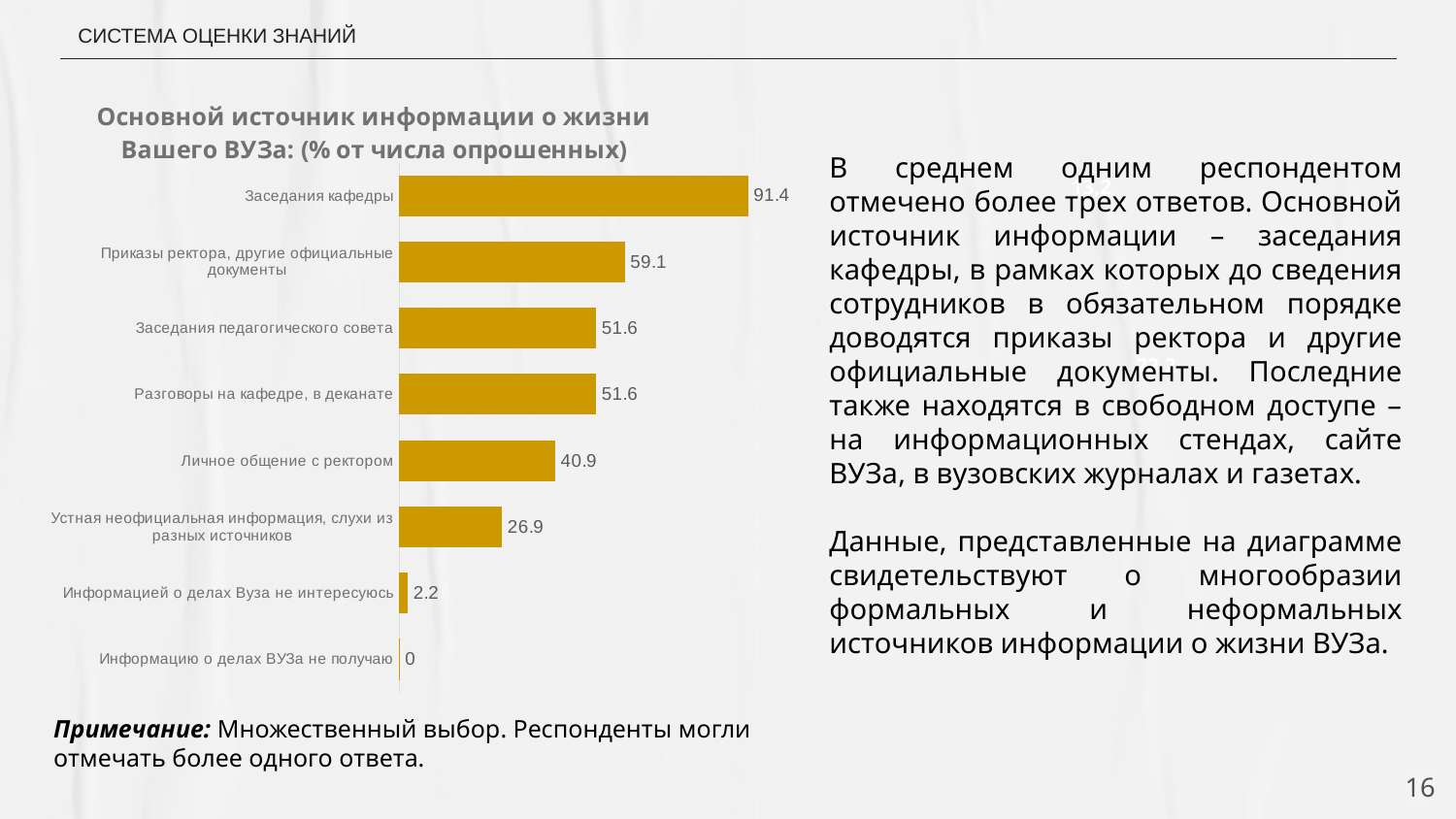
Which is larger: the value for "Личное общение с ректором" or for "Устная неофициальная информация, слухи из разных источников"? Личное общение с ректором What is the title of the chart? Основной источник информации о жизни Вашего ВУЗа: (% от числа опрошенных) Which category has the lowest value? Информацию о делах ВУЗа не получаю Which category has the highest value? Заседания кафедры What is the difference between the values for "Заседания педагогического совета" and "Личное общение с ректором"? 10.7 What is the value for "Заседания кафедры"? 91.4 What is the value for "Устная неофициальная информация, слухи из разных источников"? 26.9 What kind of chart is shown on the slide? Bar chart What is the difference between the values for "Заседания кафедры" and "Приказы ректора, другие официальные документы"? 32.3 What is the value for "Информацией о делах Вуза не интересуюсь"? 2.2 What is the value for "Личное общение с ректором"? 40.9 How many categories are shown in the chart? 8